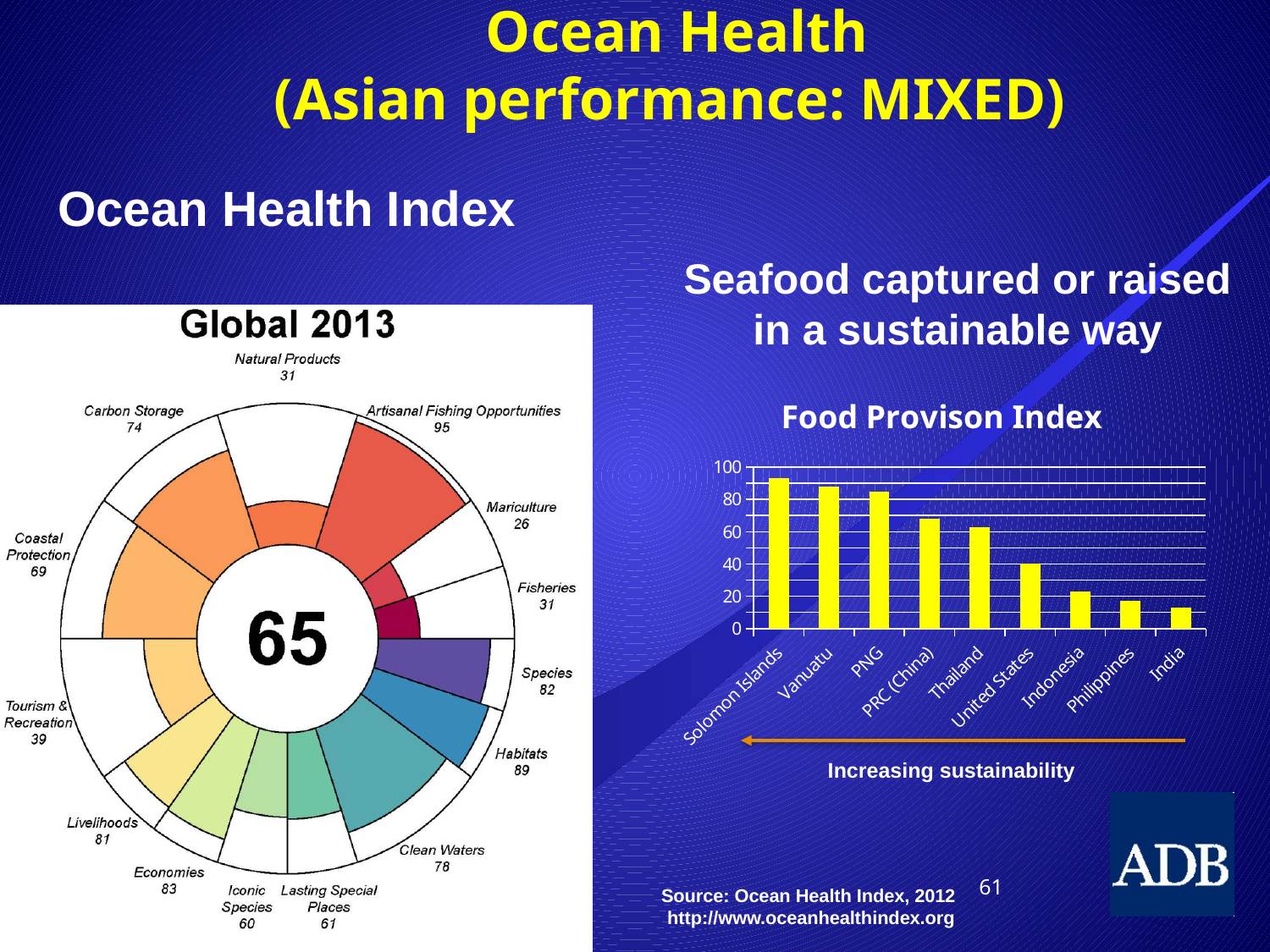
In the Global 2013 Ocean Health Index chart, what is the overall score shown in the centre? 65 In the Global 2013 Ocean Health Index chart, which goal has the highest score? Artisanal Fishing Opportunities In the Global 2013 Ocean Health Index chart, what is the difference between the Habitats score and the Fisheries score? 58 In the Global 2013 Ocean Health Index chart, which is larger, Tourism & Recreation or Livelihoods? Livelihoods How many countries are shown in the Food Provison Index bar chart? 9 In the Food Provison Index chart, do the values rise or fall from left to right? fall In the Global 2013 Ocean Health Index chart, what is the value for Mariculture? 26 In the Global 2013 Ocean Health Index chart, what is the value for Artisanal Fishing Opportunities? 95 In the Food Provison Index chart, is the value for India greater or less than 20? less In the Global 2013 Ocean Health Index chart, which goal has the lowest score? Mariculture What kind of chart is the Food Provison Index chart? bar chart In the Food Provison Index chart, which country has the highest value? Solomon Islands